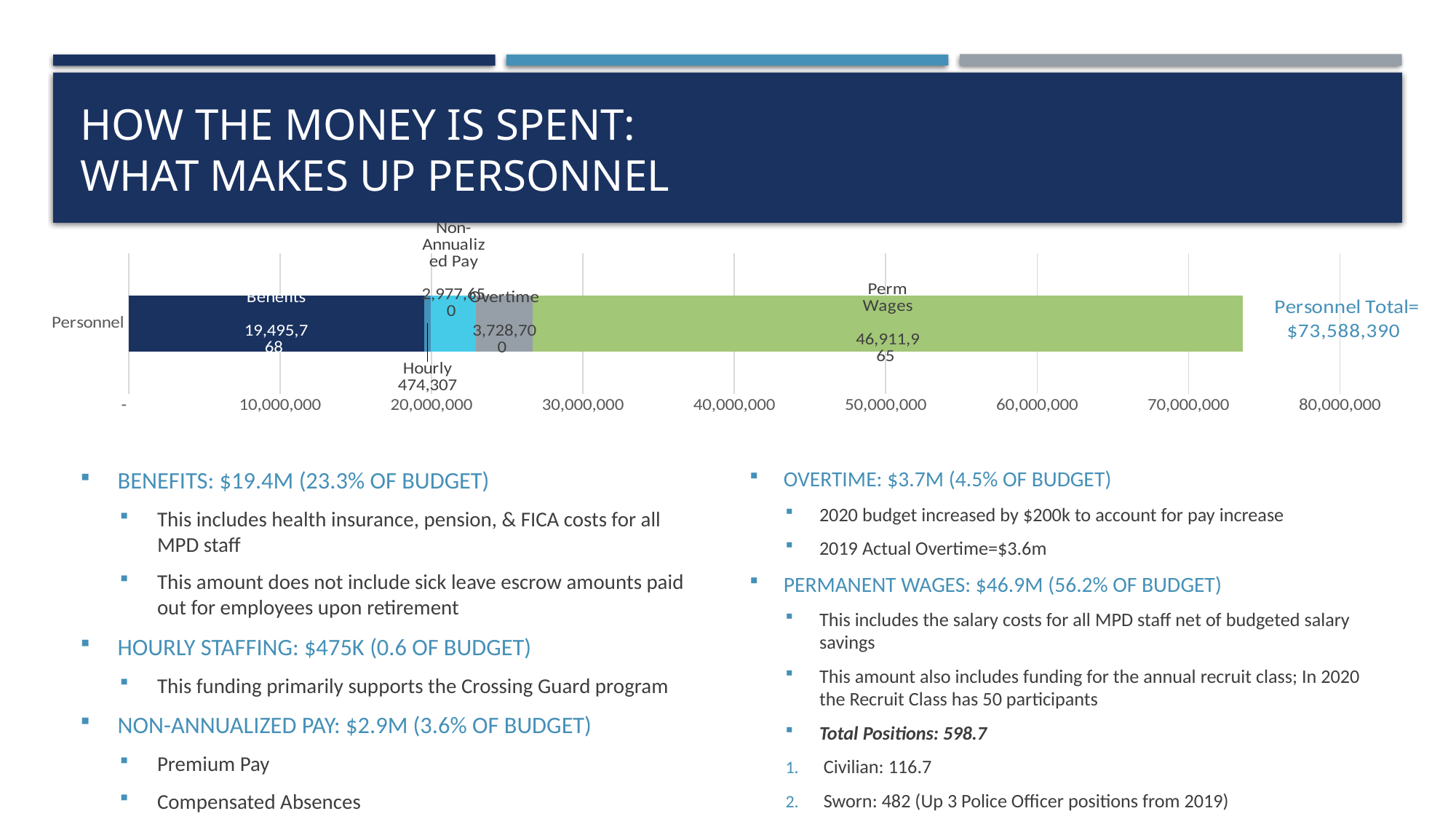
Which is larger, the Overtime segment or the Non-Annualized Pay segment? Overtime What is the value of the Overtime segment in the Personnel bar? 3,728,700 How many segments make up the Personnel bar? 5 What is the value of the Benefits segment in the Personnel bar? 19,495,768 Which segment of the Personnel bar is the smallest? Hourly What is the difference between the Perm Wages and Benefits segments? 27,416,197 What is the value of the Hourly segment in the Personnel bar? 474,307 What is the value of the Non-Annualized Pay segment in the Personnel bar? 2,977,650 Which segment of the Personnel bar is the largest? Perm Wages What type of chart is shown on the slide? stacked bar chart What is the total of the Personnel stacked bar? $73,588,390 What is the value of the Perm Wages segment in the Personnel bar? 46,911,965